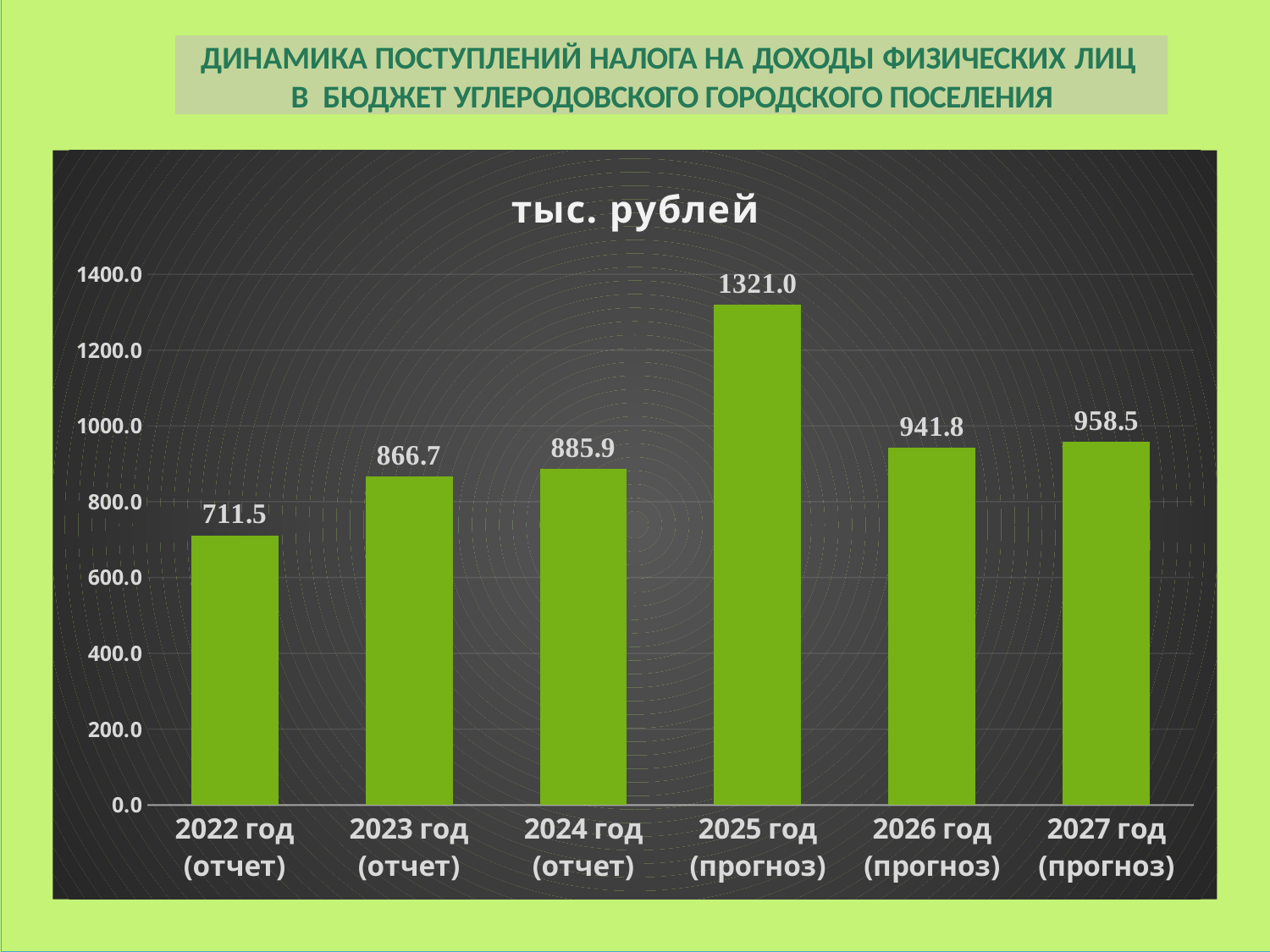
What is the value for 2022 год (отчет)? 711.5 Is the value for 2026 год (прогноз) greater or less than 1000.0? less What is the value for 2025 год (прогноз)? 1321.0 How many years are shown on the chart? 6 Which year has the lowest value? 2022 год (отчет) What is the title shown inside the chart area? тыс. рублей What kind of chart is shown on the slide? bar chart Which is larger, the value for 2023 год (отчет) or 2024 год (отчет)? 2024 год (отчет) What is the difference between the values for 2027 год (прогноз) and 2026 год (прогноз)? 16.7 What is the value for 2027 год (прогноз)? 958.5 Which year has the highest value? 2025 год (прогноз) What is the difference between the values for 2025 год (прогноз) and 2024 год (отчет)? 435.1